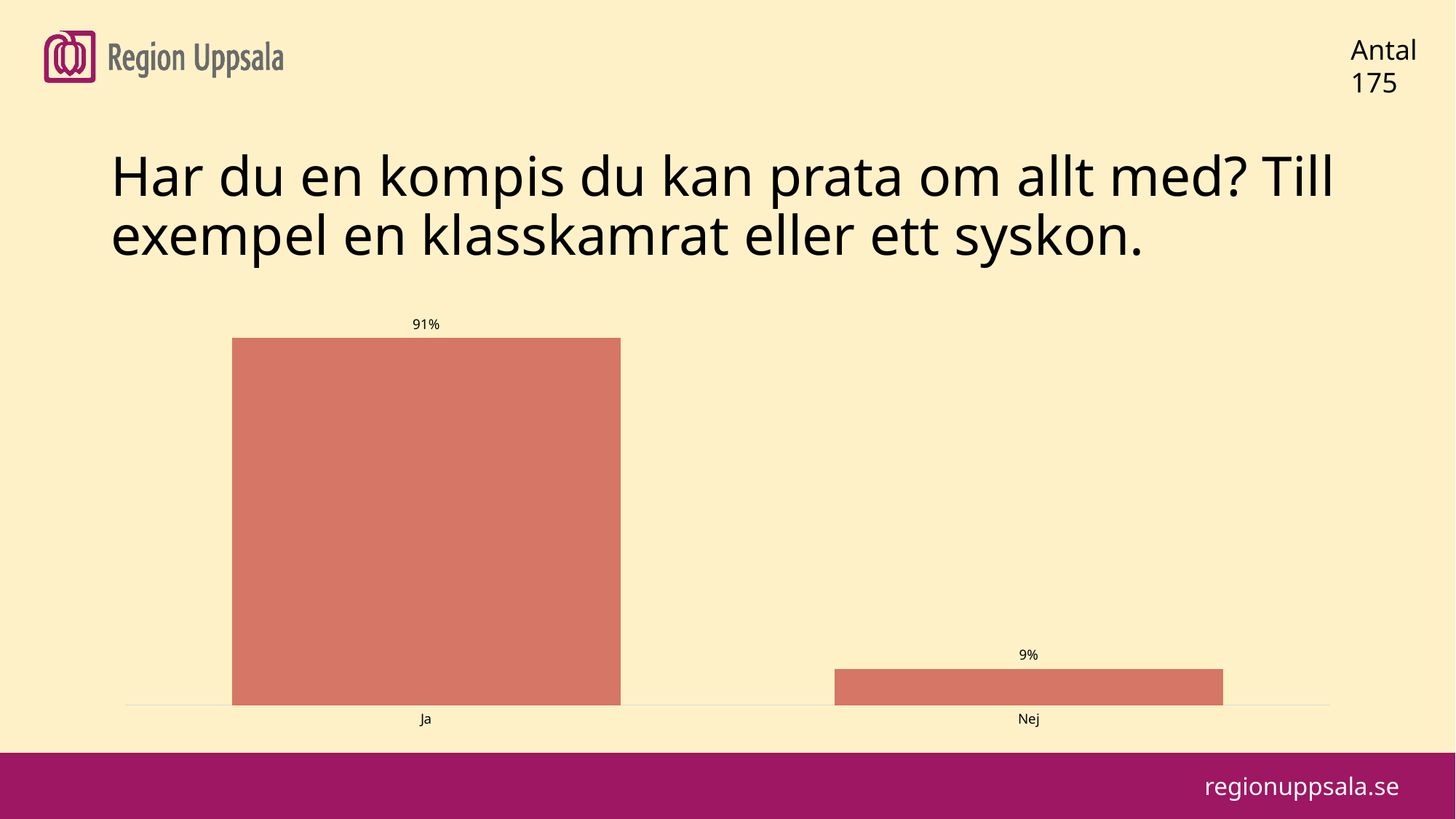
What question does the chart on the slide present results for? Har du en kompis du kan prata om allt med? Till exempel en klasskamrat eller ett syskon. What is the value for Ja? 91% Which category has the highest value? Ja What is the difference between the values for Ja and Nej? 82% Do the values rise or fall from Ja to Nej? Fall Which is larger, the value for Ja or the value for Nej? Ja What number of respondents (Antal) is shown on the slide? 175 What kind of chart is shown on the slide? Bar chart Which category has the lowest value? Nej What is the value for Nej? 9% What is the total of the values for Ja and Nej? 100% How many categories are shown in the chart? 2